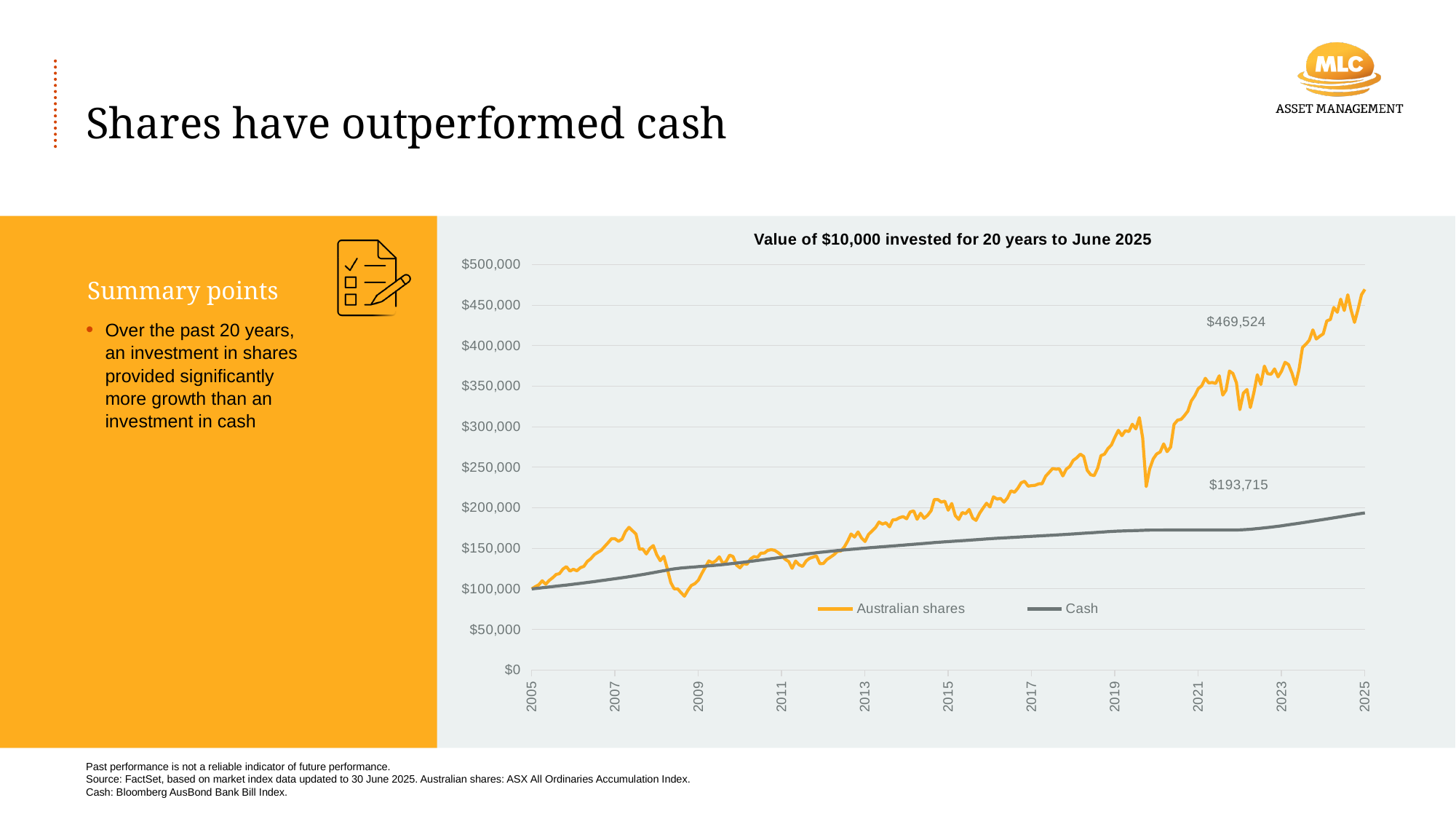
What is the labelled end value of the Australian shares series? $469,524 Is the value of the Cash series in 2015 greater or less than $200,000? less How many year labels are shown on the x axis? 11 Does the Cash series rise or fall from 2005 to 2025? rises Is the value of the Australian shares series in 2019 greater or less than $250,000? greater What is the title of the chart? Value of $10,000 invested for 20 years to June 2025 What is the labelled end value of the Cash series? $193,715 What is the difference between the labelled end values of Australian shares and Cash? $275,809 What colour is the Australian shares line in the chart? orange Which series ends at a higher value in 2025, Australian shares or Cash? Australian shares How many series does the chart's legend list? 2 What type of chart is shown on the slide? line chart